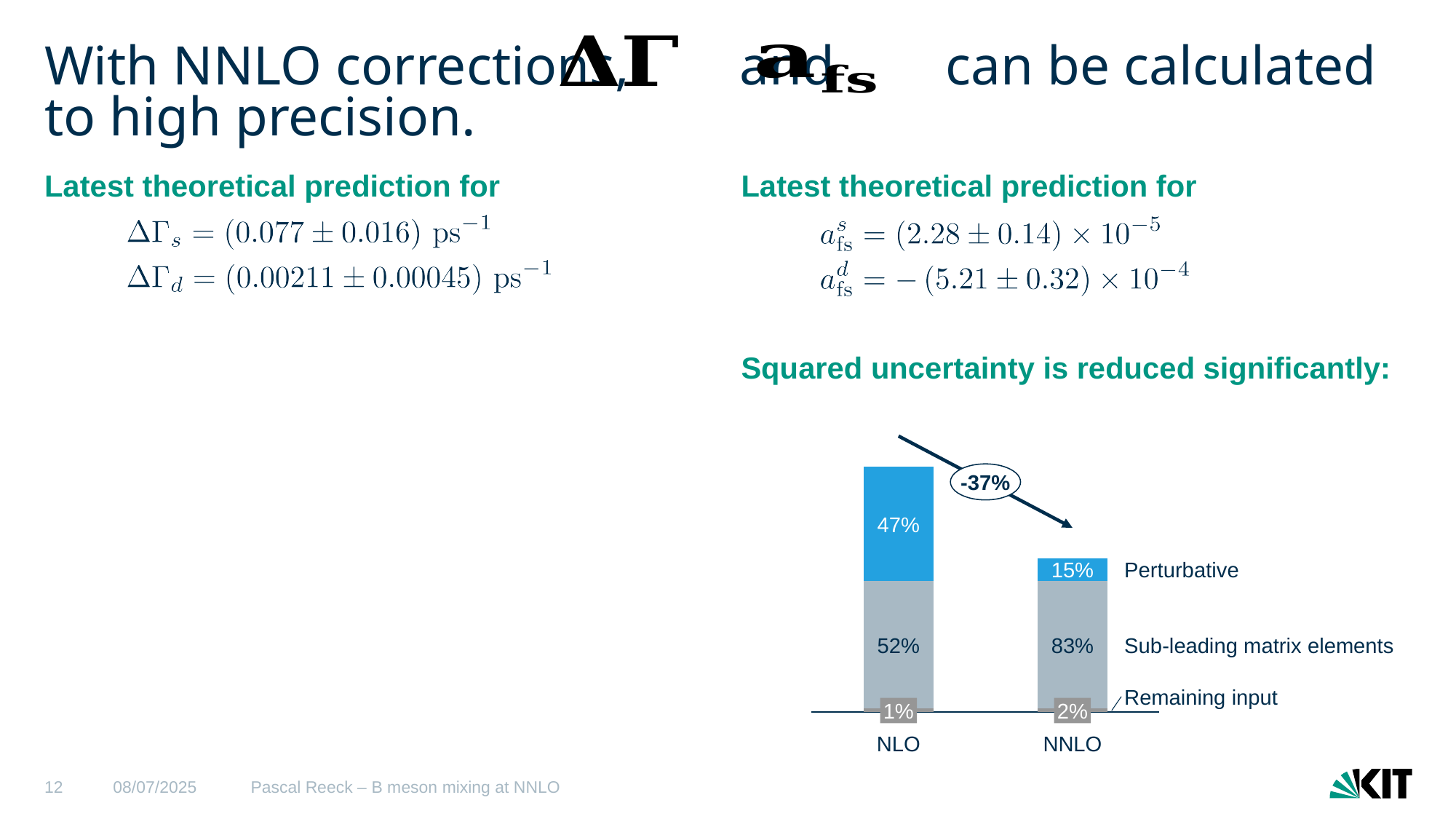
What percentage does the Perturbative segment contribute for NLO? 47% Which segment is the largest in the NNLO bar? Sub-leading matrix elements What kind of chart is shown on the slide? Stacked bar chart Does the Perturbative share rise or fall from NLO to NNLO? Fall How many series (segment types) are labelled in the stacked bars? 3 What is the Perturbative share for NNLO? 15% What percentage does the Sub-leading matrix elements segment contribute for NNLO? 83% By how many percentage points does the Perturbative share drop from NLO to NNLO? 32 percentage points Which has the larger Sub-leading matrix elements share, NLO or NNLO? NNLO How many categories are shown on the x axis of the chart? 2 What reduction percentage is written in the oval annotation above the bars? -37% What is the Remaining input share for NLO? 1%